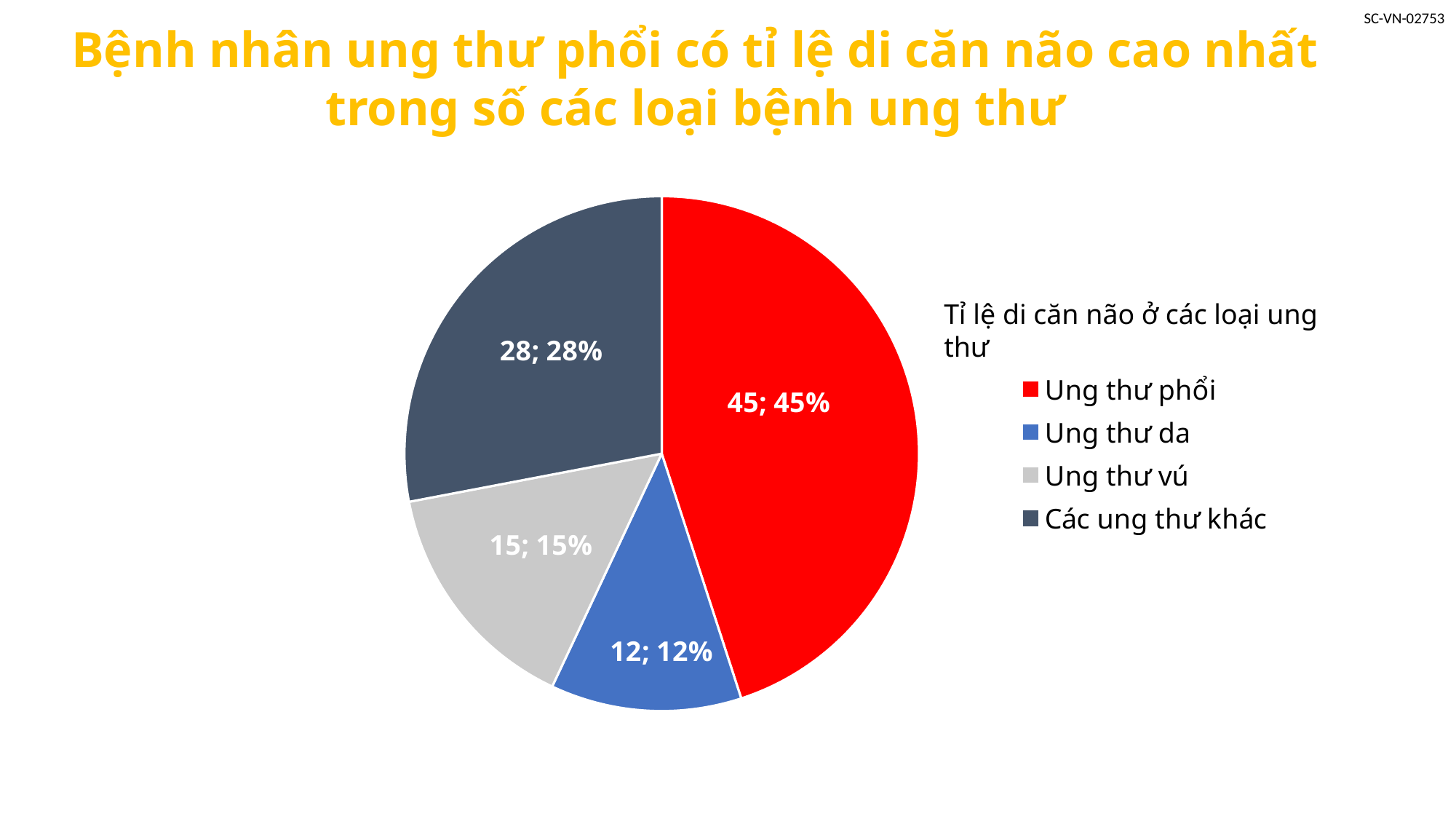
What value is shown for Ung thư da? 12 How many slices does the pie chart have? 4 What is the difference between the values for Ung thư phổi and Các ung thư khác? 17 Which category has the largest slice? Ung thư phổi Which is larger, the value for Ung thư vú or the value for Ung thư da? Ung thư vú Which category has the smallest slice? Ung thư da What percentage of the pie does Ung thư phổi account for? 45% Which colour represents Ung thư phổi in the legend? red What kind of chart is shown on the slide? pie chart What is the chart's title? Tỉ lệ di căn não ở các loại ung thư What percentage of the pie does Ung thư vú account for? 15% What value is shown for Các ung thư khác? 28